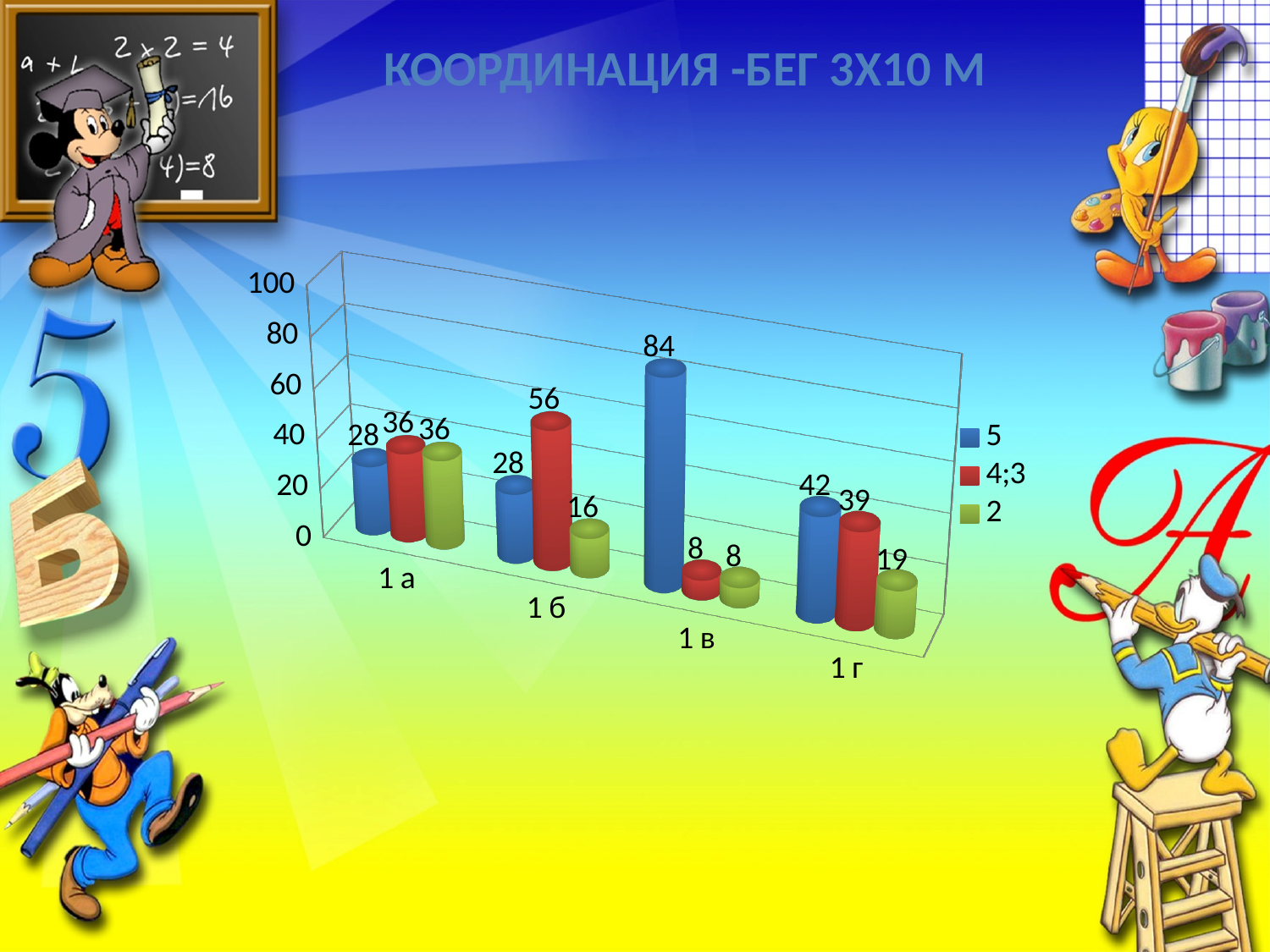
What is the difference between the "5" value and the "2" value in category "1 б"? 12 What is the value for series "5" in category "1 в"? 84 What colour are the bars for series "2"? green In category "1 г", which is larger: the value for series "5" or for series "4;3"? 5 Which category has the highest value for series "5"? 1 в How many series does the legend list? 3 What is the title of the chart? КООРДИНАЦИЯ -БЕГ 3Х10 М Which category has the lowest value for series "4;3"? 1 в What is the value for series "2" in category "1 г"? 19 What is the value for series "4;3" in category "1 б"? 56 What kind of chart is shown on the slide? bar chart How many categories are shown on the x axis? 4